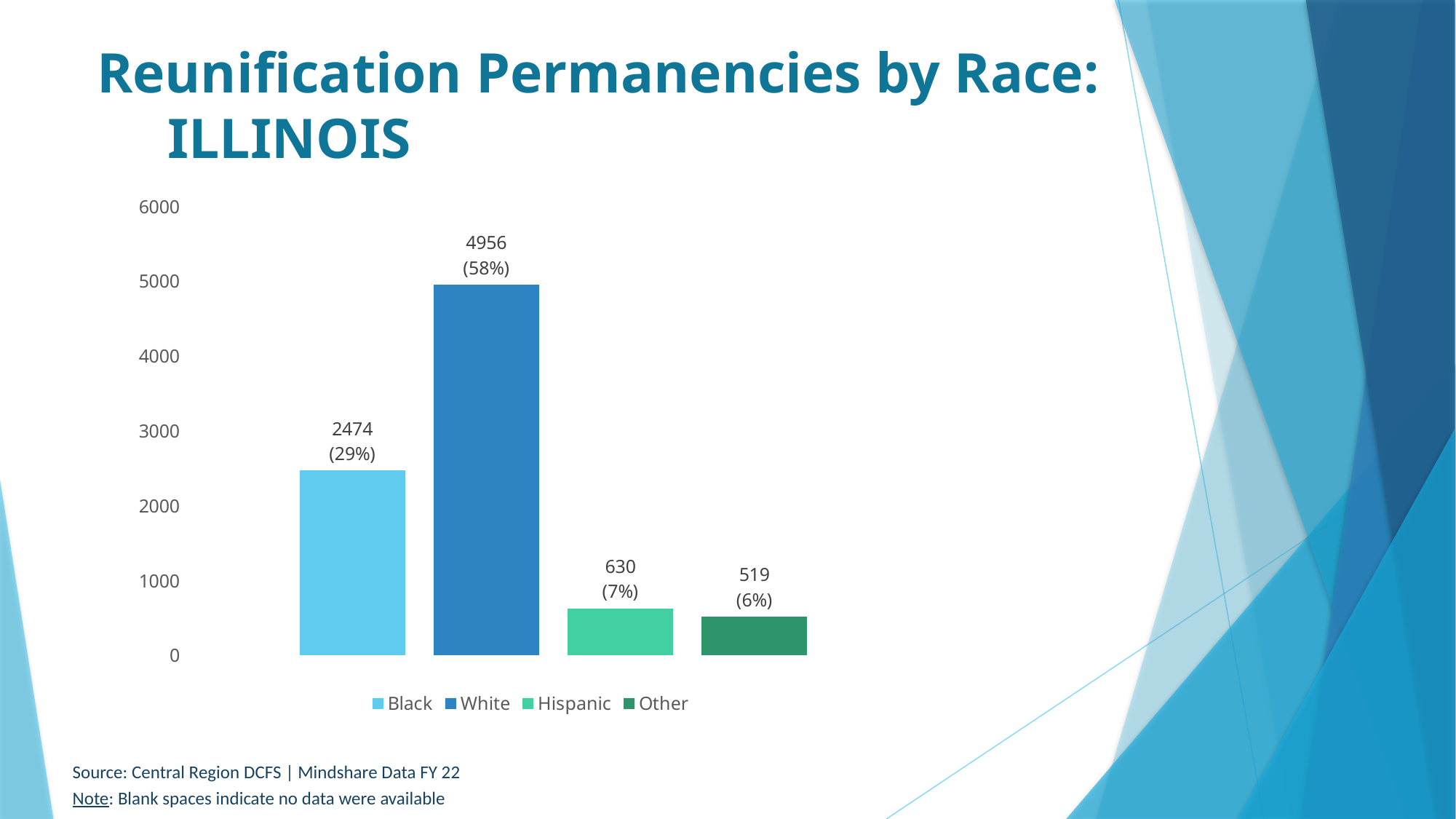
What is the title of the slide? Reunification Permanencies by Race: ILLINOIS What is the value for White? 4956 Which category has the highest value? White Which category has the lowest value? Other What is the value for Black? 2474 Is the value for Black greater or less than 2000? greater What is the difference between the values for White and Black? 2482 What kind of chart is shown on the slide? Bar chart Which is larger, the value for Hispanic or the value for Other? Hispanic How many categories are shown in the chart? 4 What percentage is shown for Other? 6% What is the value for Hispanic? 630